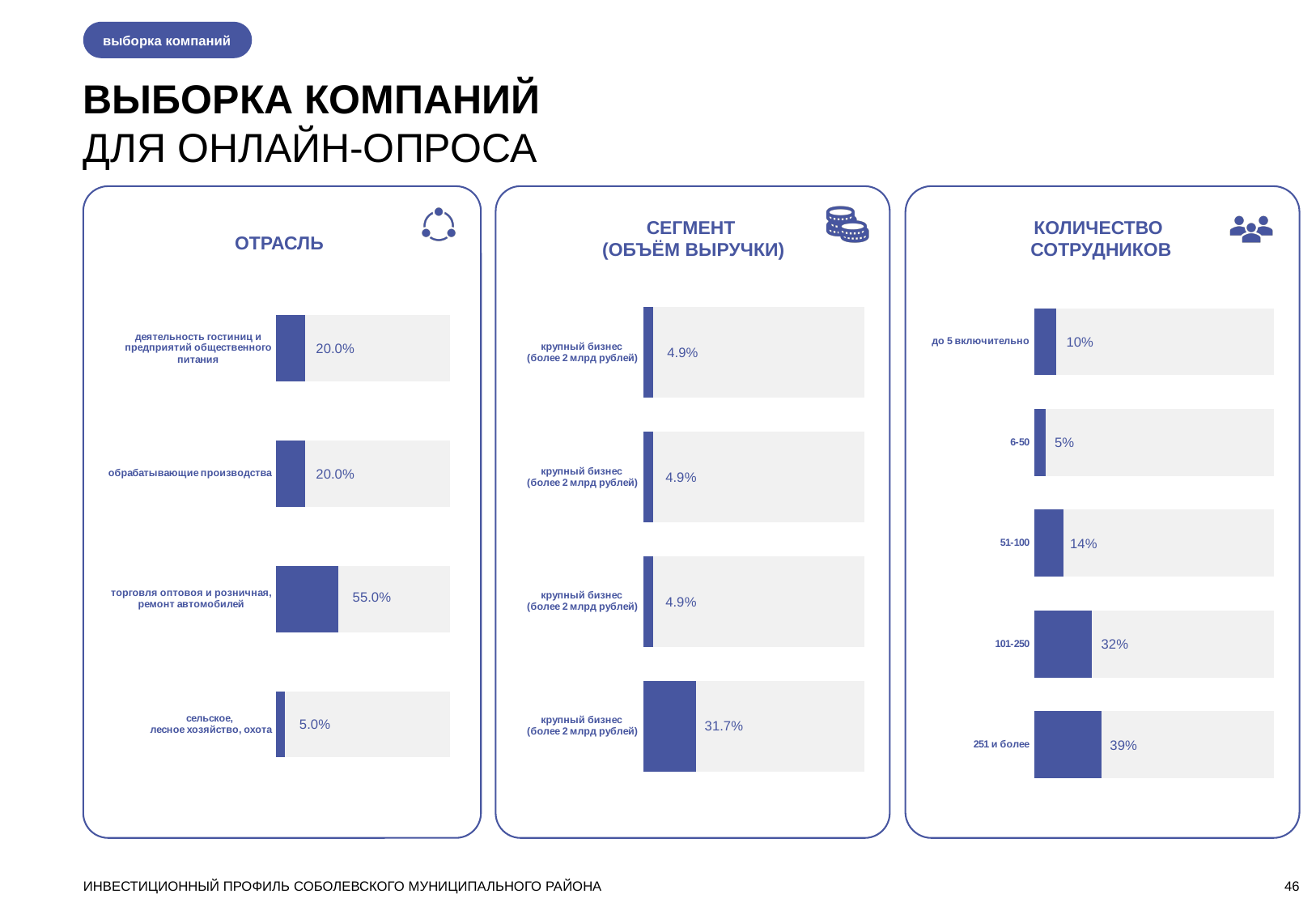
In the "КОЛИЧЕСТВО СОТРУДНИКОВ" chart, what is the difference between "251 и более" and "до 5 включительно"? 29% In the "ОТРАСЛЬ" chart, what is the value for "торговля оптовая и розничная, ремонт автомобилей"? 55.0% How many categories are shown in the "ОТРАСЛЬ" chart? 4 In the "КОЛИЧЕСТВО СОТРУДНИКОВ" chart, which category has the lowest value? 6-50 In the "КОЛИЧЕСТВО СОТРУДНИКОВ" chart, which is larger: "251 и более" or "51-100"? 251 и более In the "КОЛИЧЕСТВО СОТРУДНИКОВ" chart, what is the value for "101-250"? 32% How many bars are shown in the "СЕГМЕНТ (ОБЪЁМ ВЫРУЧКИ)" chart? 4 In the "ОТРАСЛЬ" chart, what is the difference between "торговля оптовая и розничная, ремонт автомобилей" and "обрабатывающие производства"? 35.0% In the "ОТРАСЛЬ" chart, what is the value for "сельское, лесное хозяйство, охота"? 5.0% What type of chart is the "КОЛИЧЕСТВО СОТРУДНИКОВ" chart? bar chart In the "СЕГМЕНТ (ОБЪЁМ ВЫРУЧКИ)" chart, what is the largest value shown? 31.7% In the "ОТРАСЛЬ" chart, which category has the highest value? торговля оптовая и розничная, ремонт автомобилей